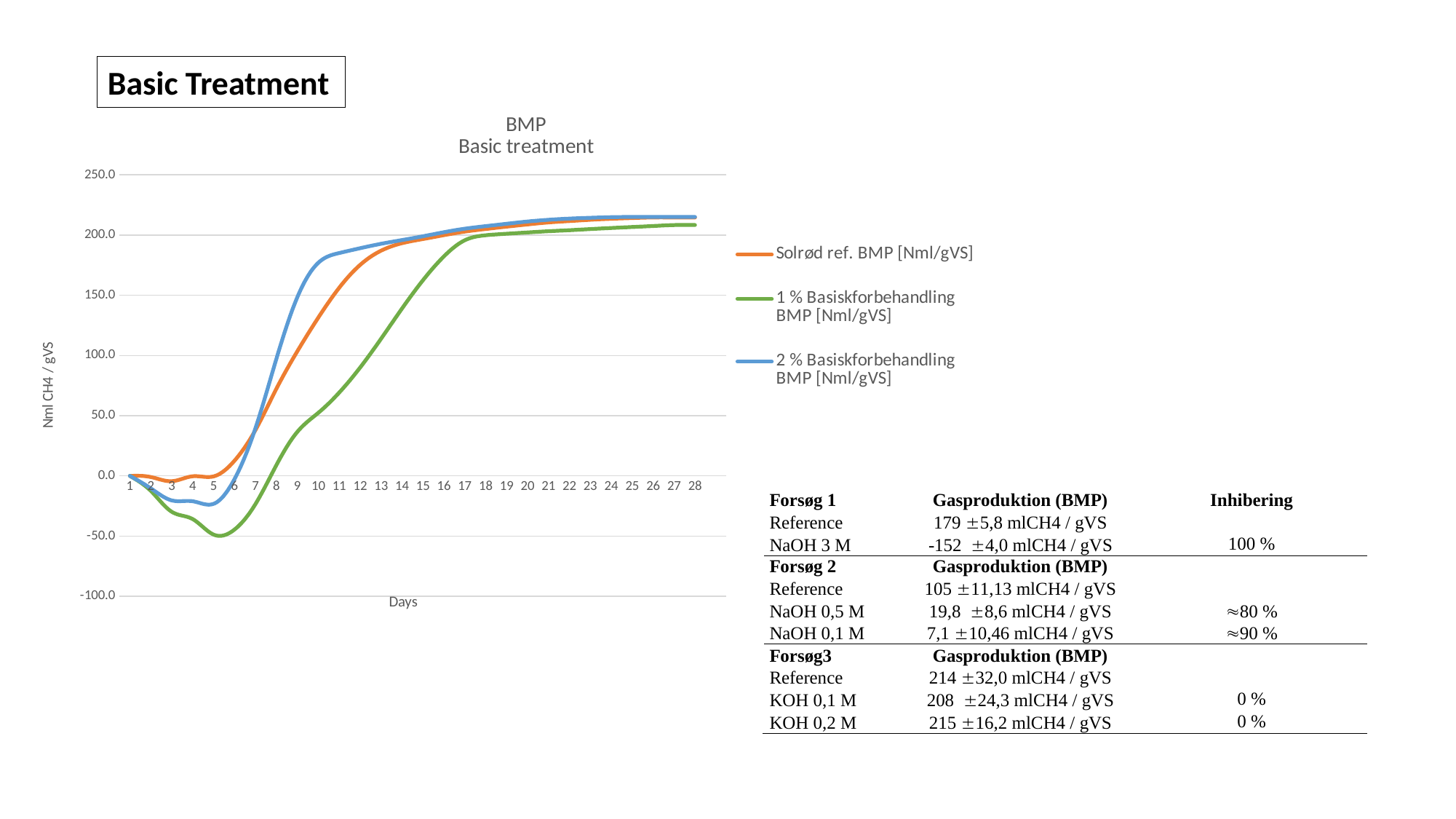
Which series reaches the lowest value on the chart? 1 % Basiskforbehandling BMP At day 10, which series has the higher value: 1 % Basiskforbehandling BMP or 2 % Basiskforbehandling BMP? 2 % Basiskforbehandling BMP Is the value for Solrød ref. BMP at day 28 greater or less than 200? greater What is the title of the chart? BMP Basic treatment How many days are shown along the x axis of the chart? 28 Is the value for 1 % Basiskforbehandling BMP at day 10 greater or less than 100? less How many series does the legend of the chart list? 3 At day 14, which series has the higher value: Solrød ref. BMP or 1 % Basiskforbehandling BMP? Solrød ref. BMP What kind of chart is shown on the slide? line chart Is the value for 2 % Basiskforbehandling BMP at day 10 greater or less than 150? greater Do the values of the Solrød ref. BMP series rise or fall overall from day 1 to day 28? rise What is the label of the vertical axis of the chart? Nml CH4 / gVS